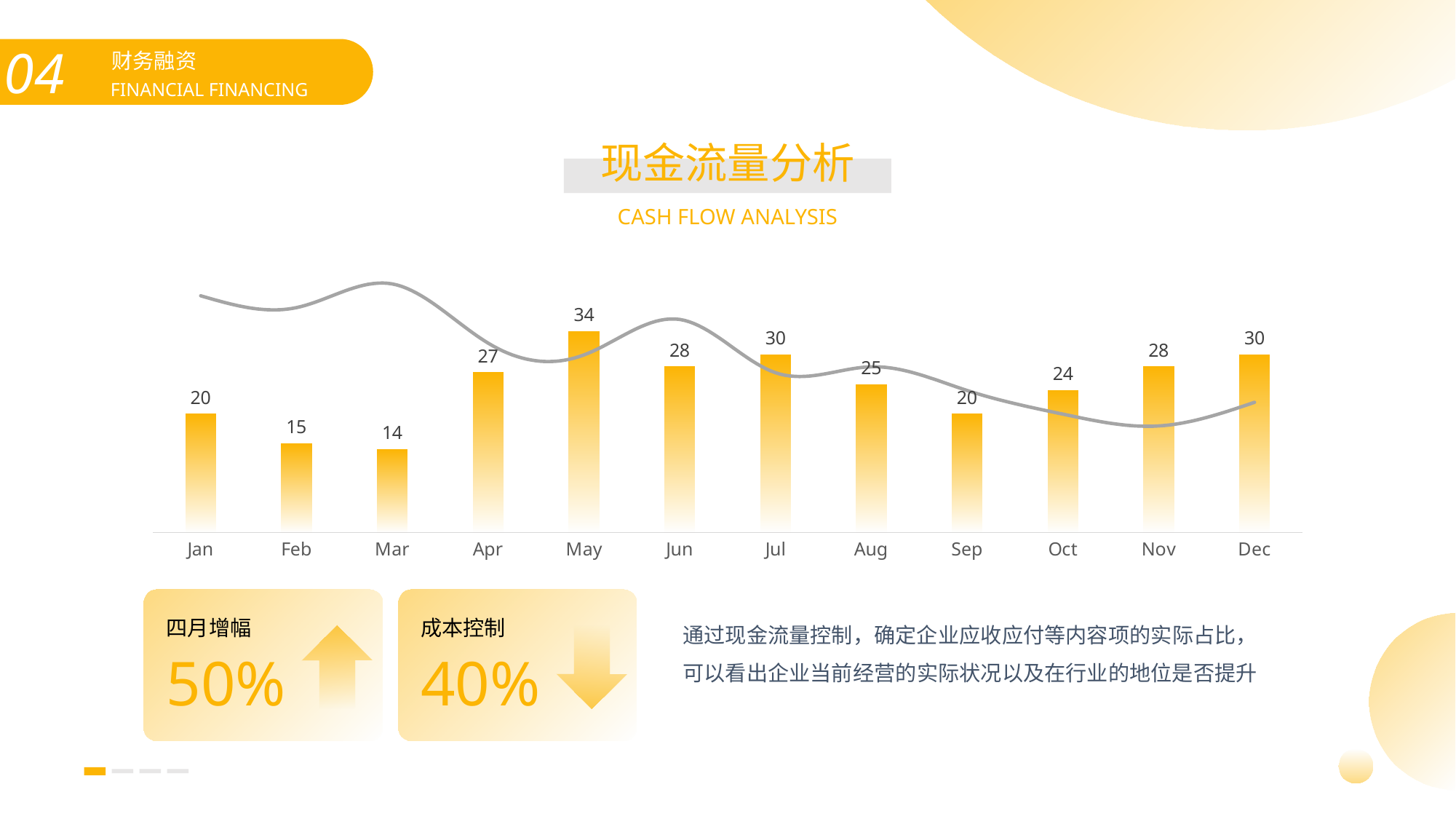
Which is larger, the value for Jun or the value for Oct? Jun What is the value for Oct? 24 Which month has the highest bar? May How many months are shown on the x axis? 12 Do the bar values rise or fall from Jan to Mar? fall Which is larger, the value for Apr or the value for Sep? Apr What is the difference between the values for May and Feb? 19 What is the value for Mar? 14 What is the English subtitle of the chart? CASH FLOW ANALYSIS Which month has the lowest bar? Mar What is the difference between the values for Jul and Aug? 5 What is the value for May? 34